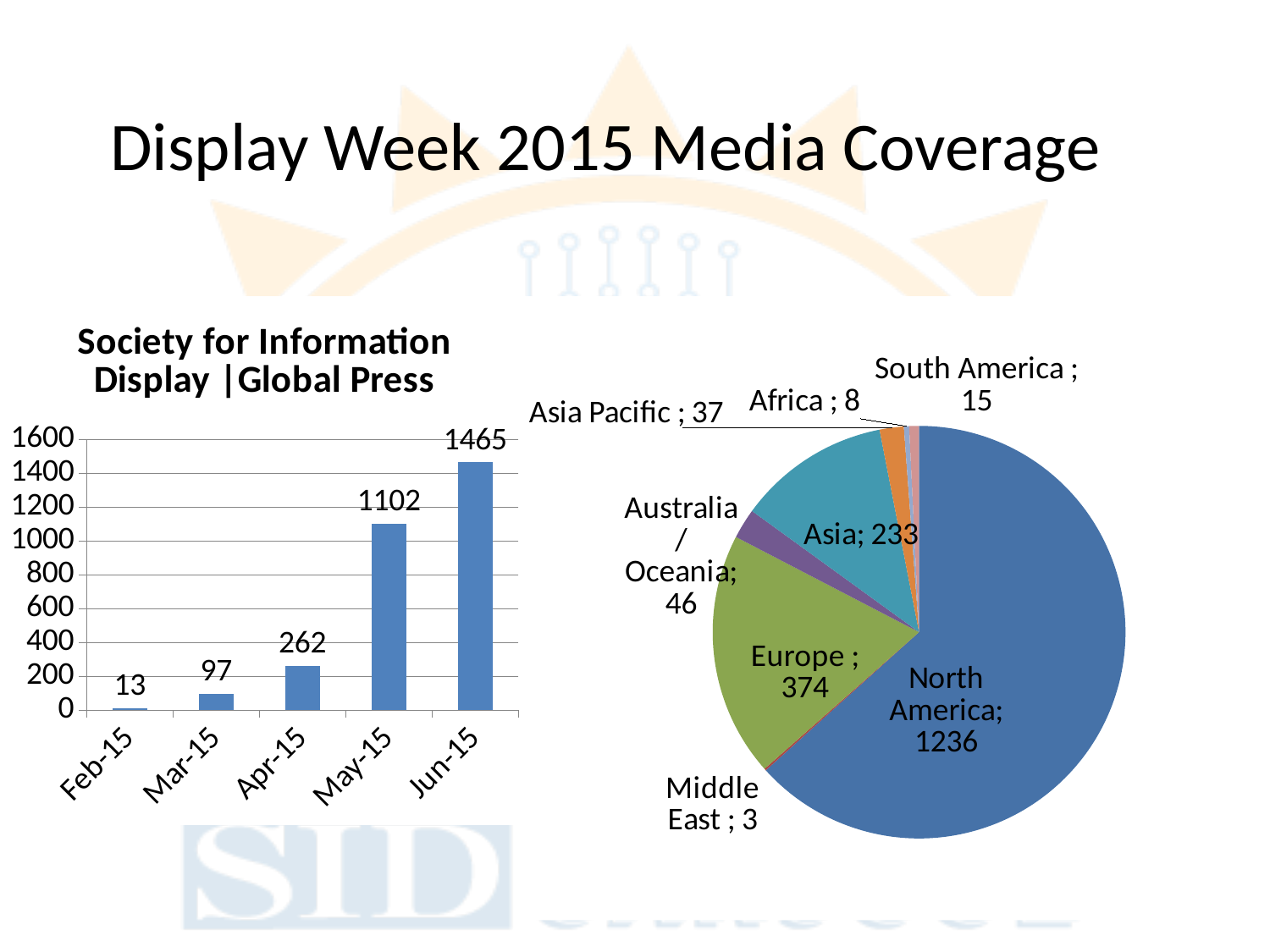
On the pie chart on the right of the slide, which region has the smallest slice? Middle East On the bar chart titled 'Society for Information Display | Global Press', what is the value for May-15? 1102 On the bar chart titled 'Society for Information Display | Global Press', do the values rise or fall from Feb-15 to Jun-15? rise On the bar chart titled 'Society for Information Display | Global Press', which month has the highest value? Jun-15 On the bar chart titled 'Society for Information Display | Global Press', how many months are plotted? 5 On the bar chart titled 'Society for Information Display | Global Press', what is the value for Feb-15? 13 On the pie chart on the right of the slide, which region has the largest slice? North America On the pie chart on the right of the slide, what is the value for Europe? 374 On the pie chart on the right of the slide, which is larger: Asia or Asia Pacific? Asia On the bar chart titled 'Society for Information Display | Global Press', which month has the lowest value? Feb-15 What kind of chart is the one on the left of the slide? bar chart On the bar chart titled 'Society for Information Display | Global Press', what is the difference between the values for Jun-15 and May-15? 363